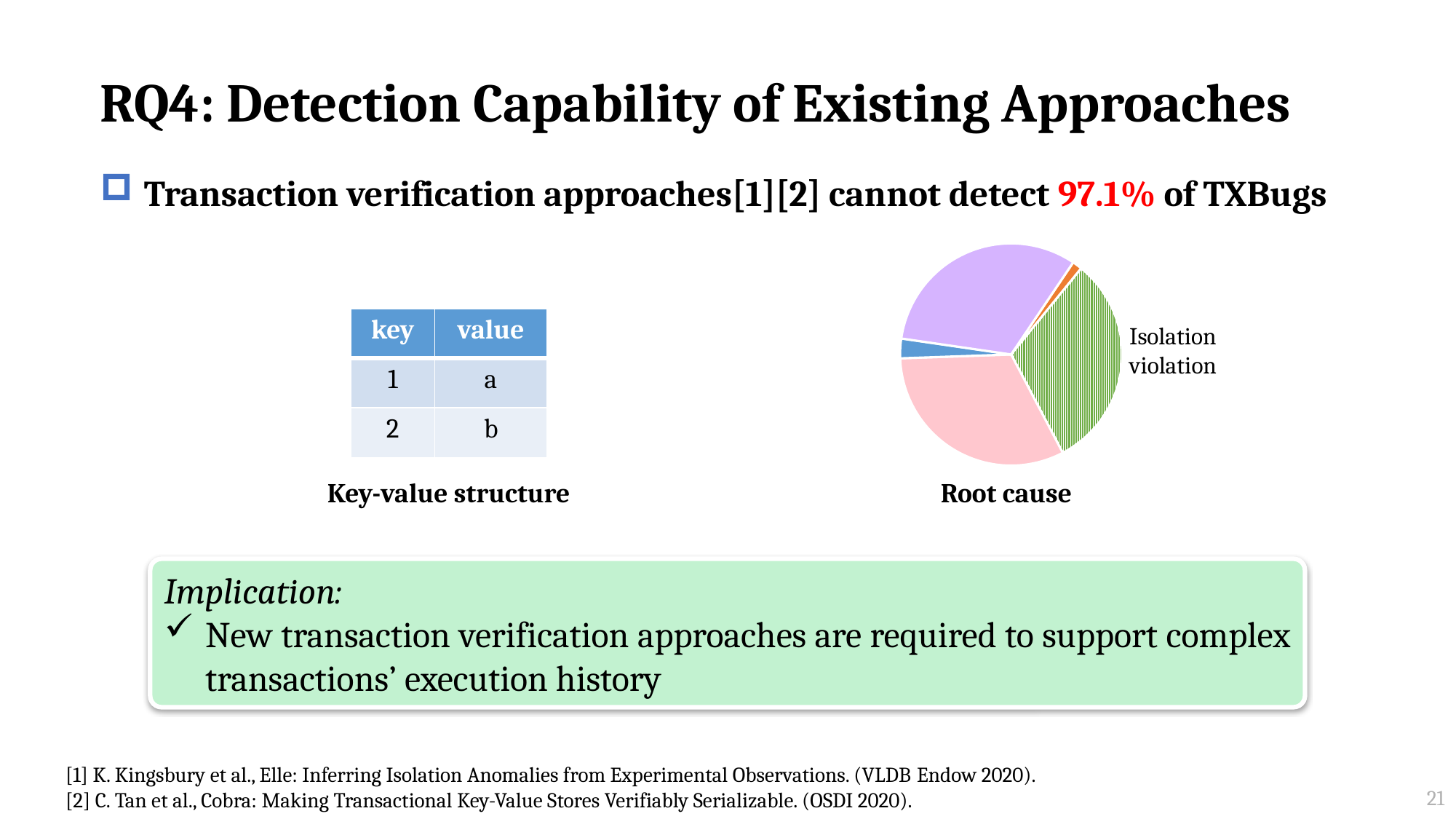
How many slices does the "Root cause" pie chart have? 5 Which slice of the "Root cause" pie chart is the smallest? the orange slice Which slice of the "Root cause" pie chart is labeled on the slide? Isolation violation What is the title of the pie chart on the slide? Root cause In the "Root cause" pie chart, which is larger: the "Isolation violation" slice or the orange slice? Isolation violation What kind of chart is the "Root cause" chart? pie chart In the "Root cause" pie chart, which is larger: the pink slice or the blue slice? the pink slice